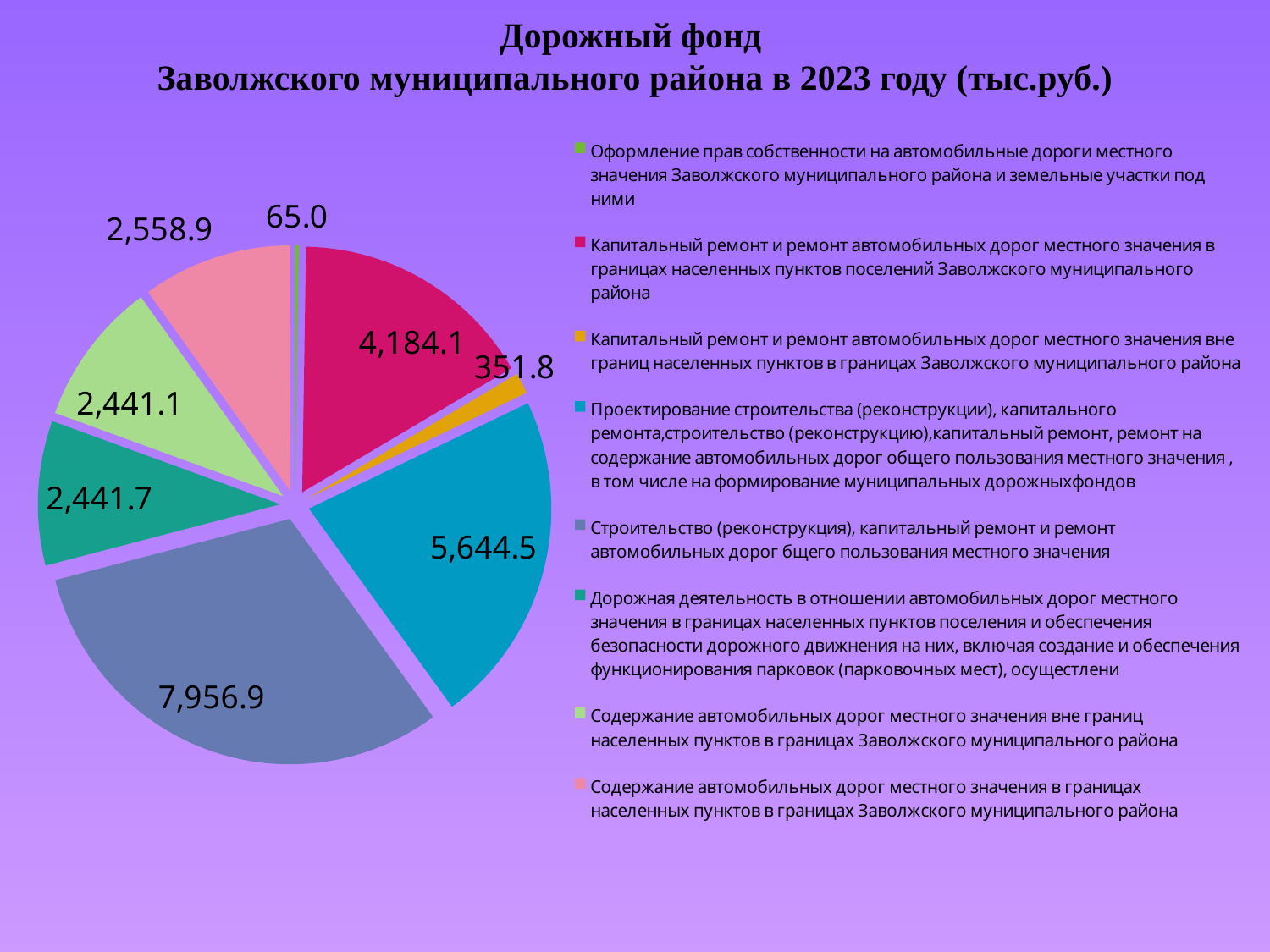
What is the difference between the 'Дорожная деятельность...' slice (2,441.7) and the 'Содержание автомобильных дорог местного значения вне границ населенных пунктов...' slice (2,441.1)? 0.6 What is the title of the chart on the slide? Дорожный фонд Заволжского муниципального района в 2023 году (тыс.руб.) What is the value for 'Проектирование строительства (реконструкции), капитального ремонта...' (the blue slice)? 5,644.5 What is the value for 'Оформление прав собственности на автомобильные дороги местного значения...'? 65.0 What is the value for 'Строительство (реконструкция), капитальный ремонт и ремонт автомобильных дорог общего пользования местного значения'? 7,956.9 What is the value for 'Капитальный ремонт и ремонт автомобильных дорог местного значения вне границ населенных пунктов...'? 351.8 Which category has the largest slice of the pie? Строительство (реконструкция), капитальный ремонт и ремонт автомобильных дорог общего пользования местного значения How many slices does the pie chart have? 8 Which category has the smallest slice of the pie? Оформление прав собственности на автомобильные дороги местного значения Заволжского муниципального района и земельные участки под ними What kind of chart is shown on the slide? Pie chart What is the difference between the largest slice (7,956.9) and the 'Проектирование строительства...' slice (5,644.5)? 2,312.4 Which is larger: 'Капитальный ремонт и ремонт автомобильных дорог местного значения в границах населенных пунктов...' or 'Содержание автомобильных дорог местного значения в границах населенных пунктов...'? Капитальный ремонт и ремонт автомобильных дорог местного значения в границах населенных пунктов поселений Заволжского муниципального района